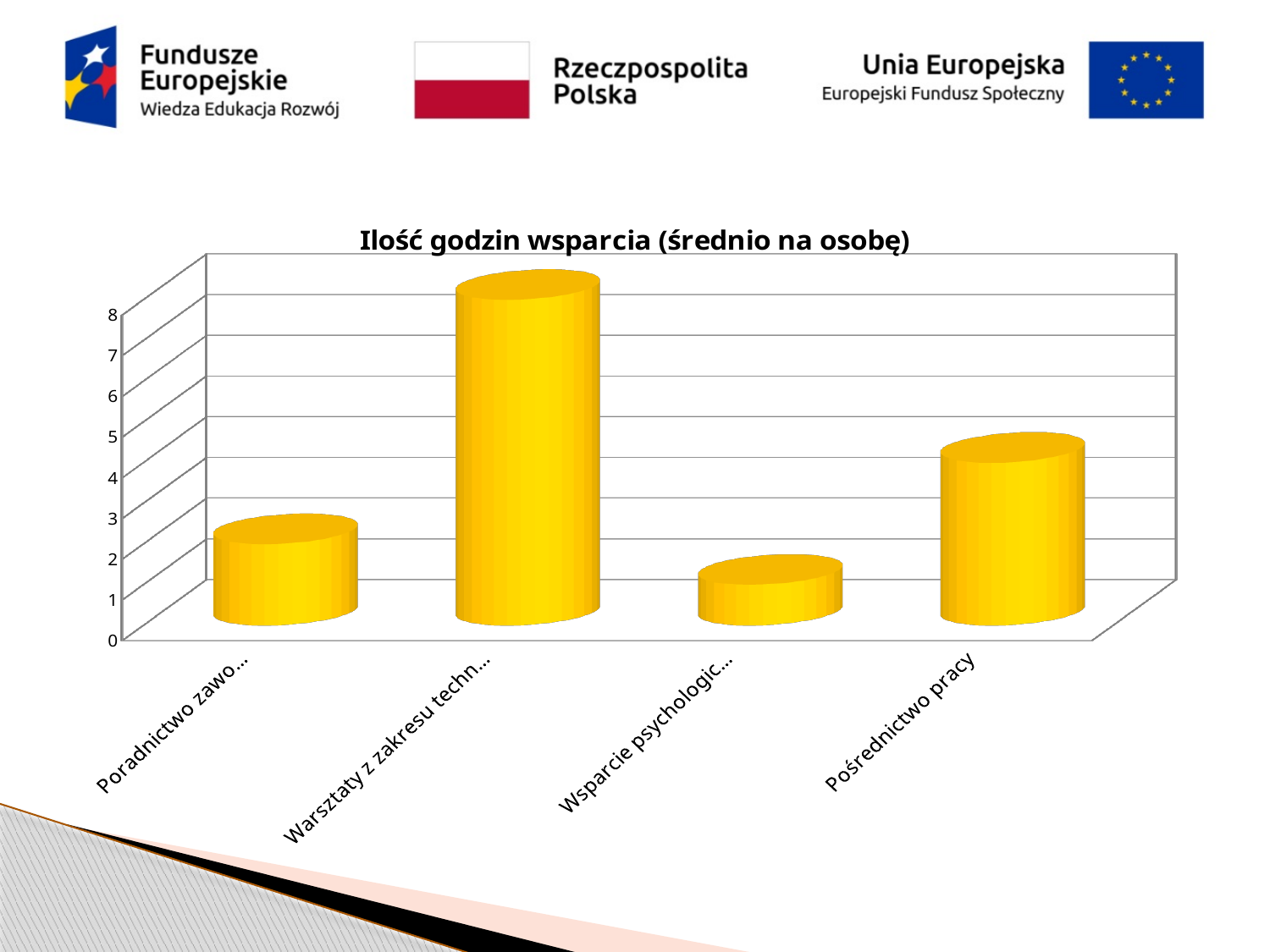
Which is larger, the value for Warsztaty z zakresu techn... or the value for Pośrednictwo pracy? Warsztaty z zakresu techn... How many categories are plotted in the chart? 4 What kind of chart is shown on the slide? bar chart Is the value for Warsztaty z zakresu techn... greater or less than 6? greater Is the value for Poradnictwo zawo... greater or less than 4? less Which category has the lowest value? Wsparcie psychologic... Is the value for Wsparcie psychologic... greater or less than 3? less Which category has the highest value? Warsztaty z zakresu techn... What is the title of the chart? Ilość godzin wsparcia (średnio na osobę) Which is larger, the value for Pośrednictwo pracy or the value for Poradnictwo zawo...? Pośrednictwo pracy What is the highest value shown on the vertical axis? 8